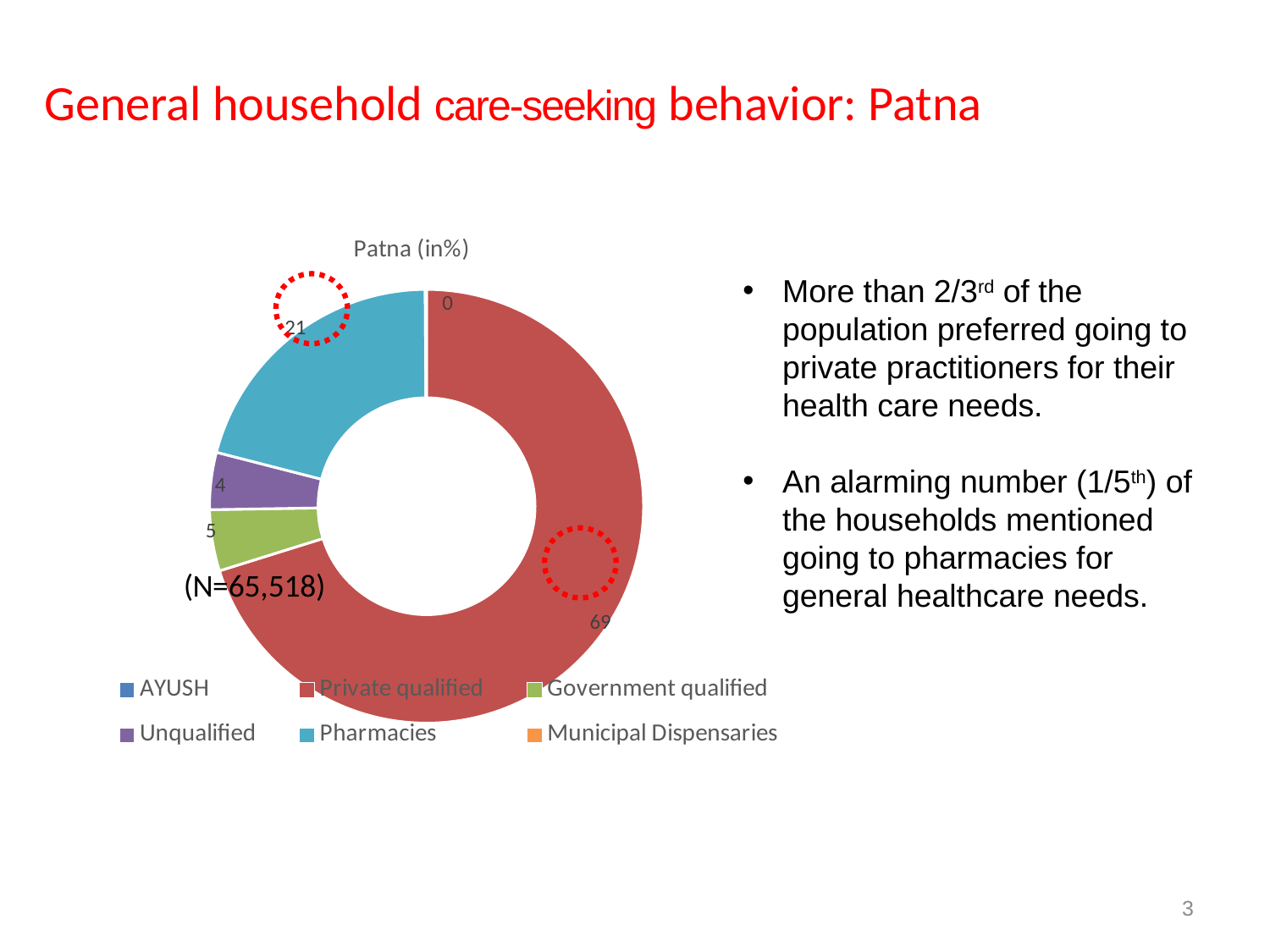
How many categories does the legend of the Patna (in%) chart list? 6 What is the value for Pharmacies in the Patna (in%) chart? 21 What is the value for Private qualified in the Patna (in%) chart? 69 What is the value for Government qualified in the Patna (in%) chart? 5 What is the difference between the values for Private qualified and Pharmacies in the Patna (in%) chart? 48 What is the value for Unqualified in the Patna (in%) chart? 4 What is the title of the chart on the slide? Patna (in%) What is the difference between the values for Government qualified and Unqualified in the Patna (in%) chart? 1 What kind of chart is shown on the slide? doughnut chart What sample size (N) is shown next to the chart? N=65,518 Which category has the largest slice in the Patna (in%) chart? Private qualified Which is larger in the Patna (in%) chart, Pharmacies or Government qualified? Pharmacies